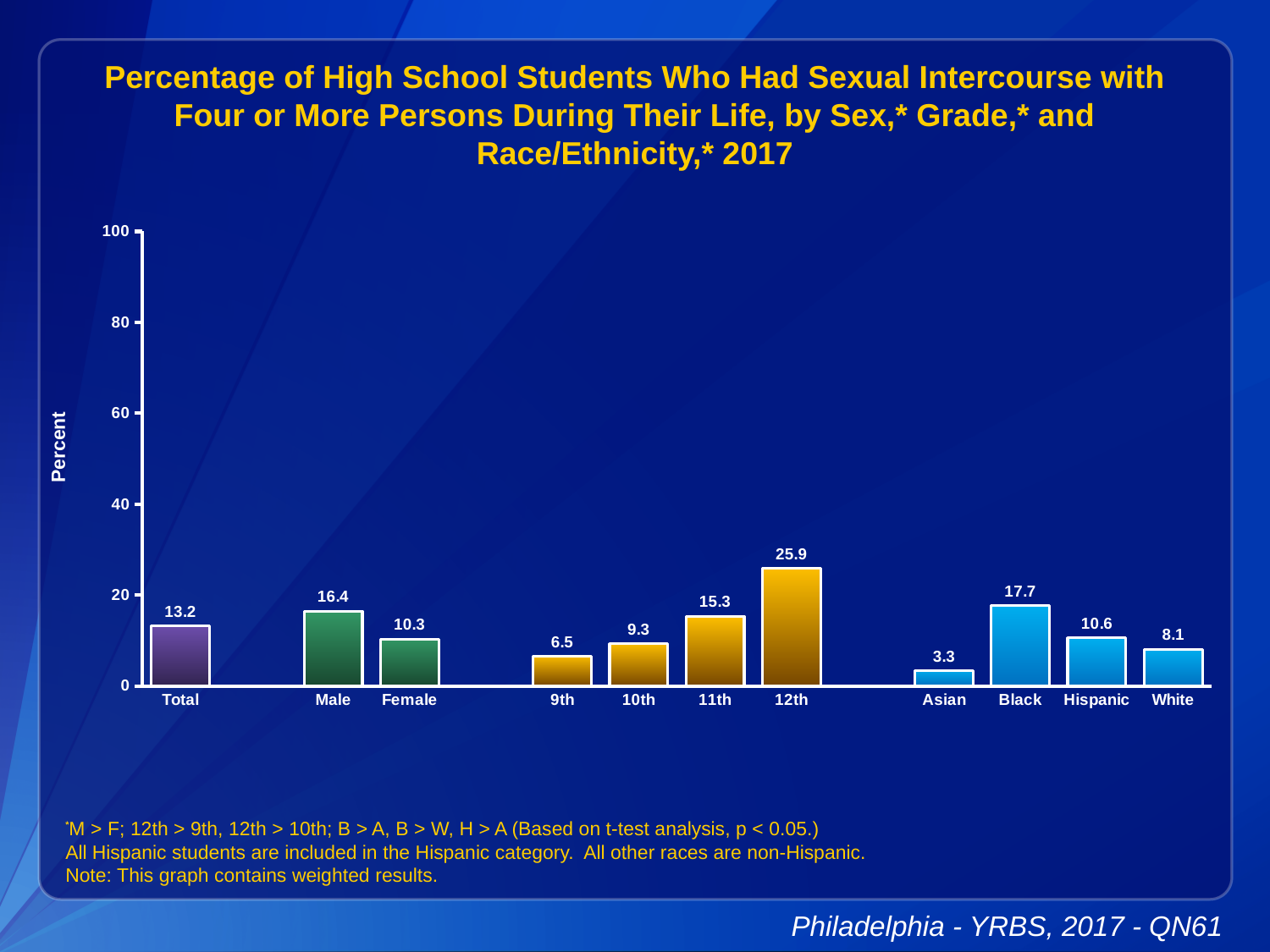
Which is larger, the value for 10th grade or the value for 11th grade? 11th What is the value for Total? 13.2 Is the value for 12th grade greater or less than 20? greater What is the value for 12th grade students? 25.9 What is the value for Asian students? 3.3 What is the difference between the values for Male and Female? 6.1 Which category has the lowest value? Asian What kind of chart is shown on the slide? bar chart Do the values rise or fall from 9th grade to 12th grade? rise Which category has the highest value? 12th How many bars are shown in the chart? 11 What is the difference between the values for Black and White students? 9.6